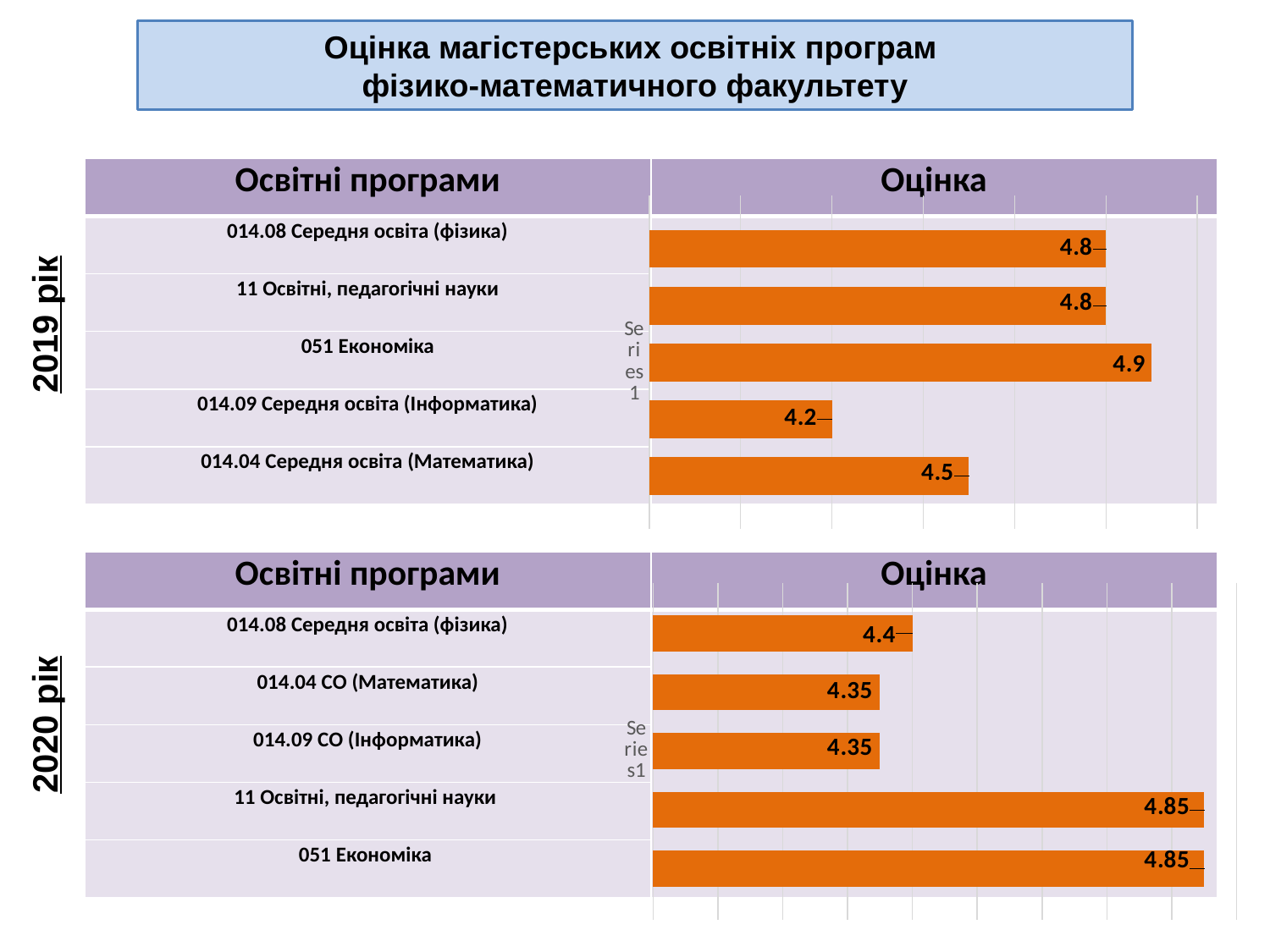
In the 2020 рік chart, what is the value for 014.08 Середня освіта (фізика)? 4.4 In the 2019 рік chart, which program has the lowest value? 014.09 Середня освіта (Інформатика) In the 2020 рік chart, which is larger: the value for 051 Економіка or the value for 014.04 СО (Математика)? 051 Економіка What is the title shown at the top of the slide? Оцінка магістерських освітніх програм фізико-математичного факультету In the 2019 рік chart, which program has the highest value? 051 Економіка In the 2019 рік chart, what is the value for 051 Економіка? 4.9 In the 2020 рік chart, what is the value for 11 Освітні, педагогічні науки? 4.85 In the 2019 рік chart, what is the difference between the values for 051 Економіка and 014.04 Середня освіта (Математика)? 0.4 What kind of chart is the 2020 рік chart? Bar chart In the 2019 рік chart, what is the value for 014.09 Середня освіта (Інформатика)? 4.2 In the 2020 рік chart, what is the difference between the values for 11 Освітні, педагогічні науки and 014.09 СО (Інформатика)? 0.5 In the 2019 рік chart, how many programs are plotted? 5